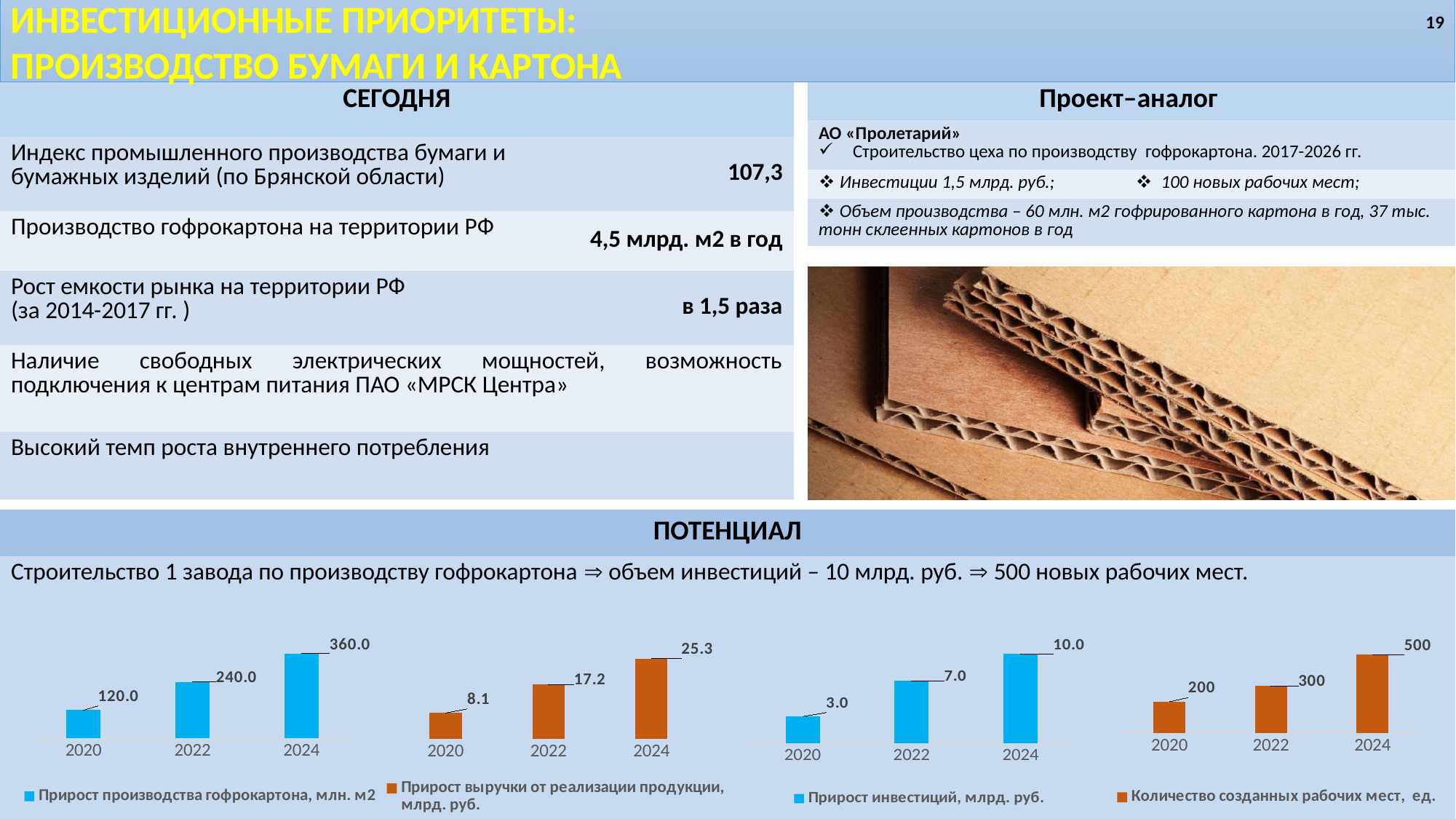
How many years (categories) are shown in the third chart from the left (Прирост инвестиций, млрд. руб.)? 3 What type of chart is the second chart from the left (Прирост выручки от реализации продукции, млрд. руб.)? bar chart In the second chart from the left (Прирост выручки от реализации продукции, млрд. руб.), what is the value for 2022? 17.2 In the third chart from the left (Прирост инвестиций, млрд. руб.), which year has the highest value? 2024 In the third chart from the left (Прирост инвестиций, млрд. руб.), what is the value for 2022? 7.0 In the leftmost chart (Прирост производства гофрокартона, млн. м2), do the values rise or fall from 2020 to 2024? rise In the rightmost chart (Количество созданных рабочих мест, ед.), what is the difference between the 2022 and 2020 values? 100 In the rightmost chart (Количество созданных рабочих мест, ед.), which year has the lowest value? 2020 In the rightmost chart (Количество созданных рабочих мест, ед.), what is the value for 2024? 500 In the second chart from the left (Прирост выручки от реализации продукции, млрд. руб.), what is the difference between the 2024 and 2020 values? 17.2 In the leftmost chart (Прирост производства гофрокартона, млн. м2), what is the value for 2020? 120.0 In the leftmost chart (Прирост производства гофрокартона, млн. м2), what is the value for 2024? 360.0